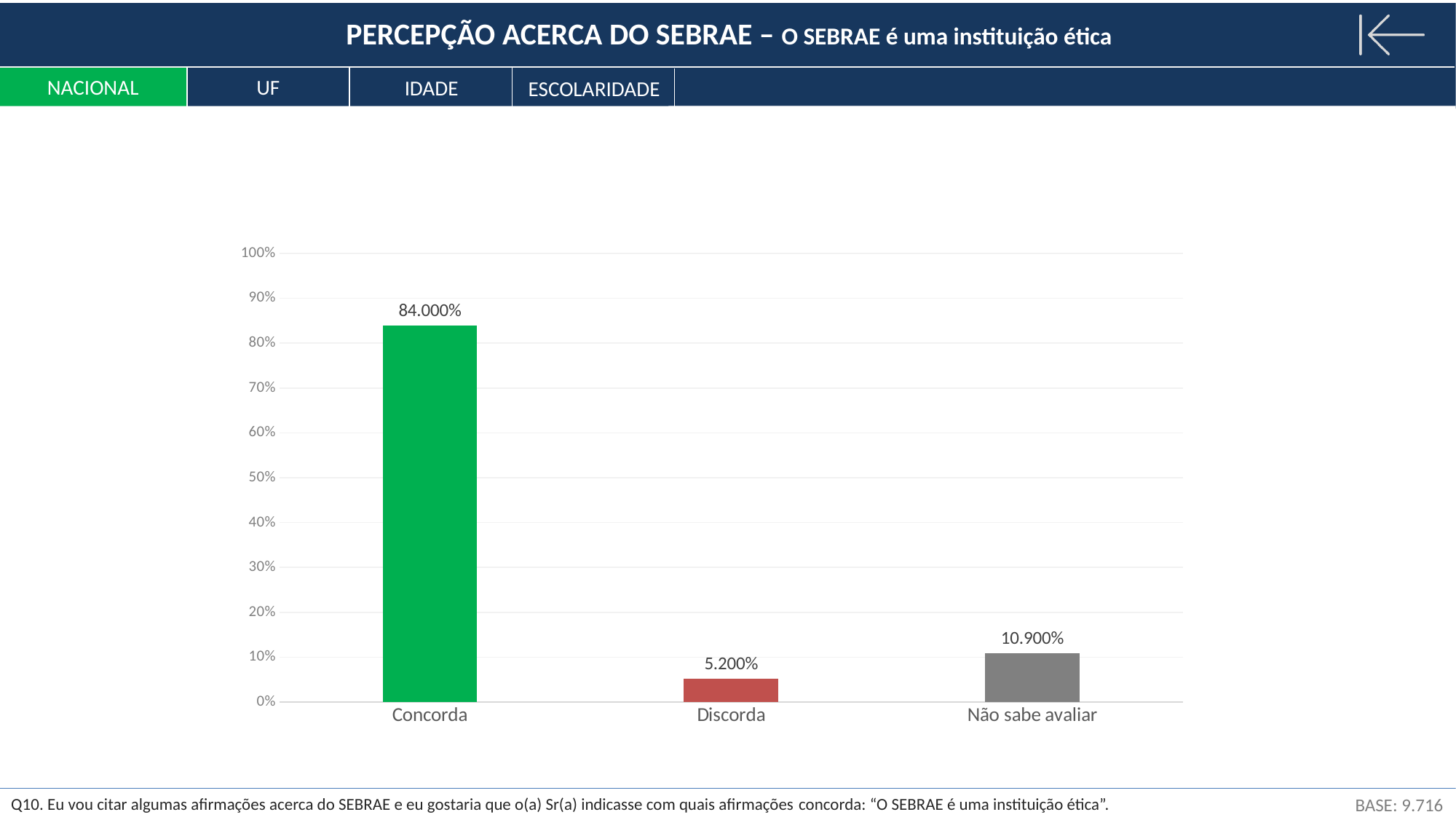
What is the difference between the values for Concorda and Não sabe avaliar? 73.100% What is the value for Discorda? 5.200% What is the value for Não sabe avaliar? 10.900% Which is larger, the value for Discorda or the value for Não sabe avaliar? Não sabe avaliar How many categories are shown on the x axis? 3 Which category has the lowest value? Discorda Which category has the highest value? Concorda Is the value for Concorda greater or less than 80%? greater What is the difference between the values for Não sabe avaliar and Discorda? 5.700% What kind of chart is shown on the slide? bar chart What is the value for Concorda? 84.000% What colour is the bar for Concorda? green